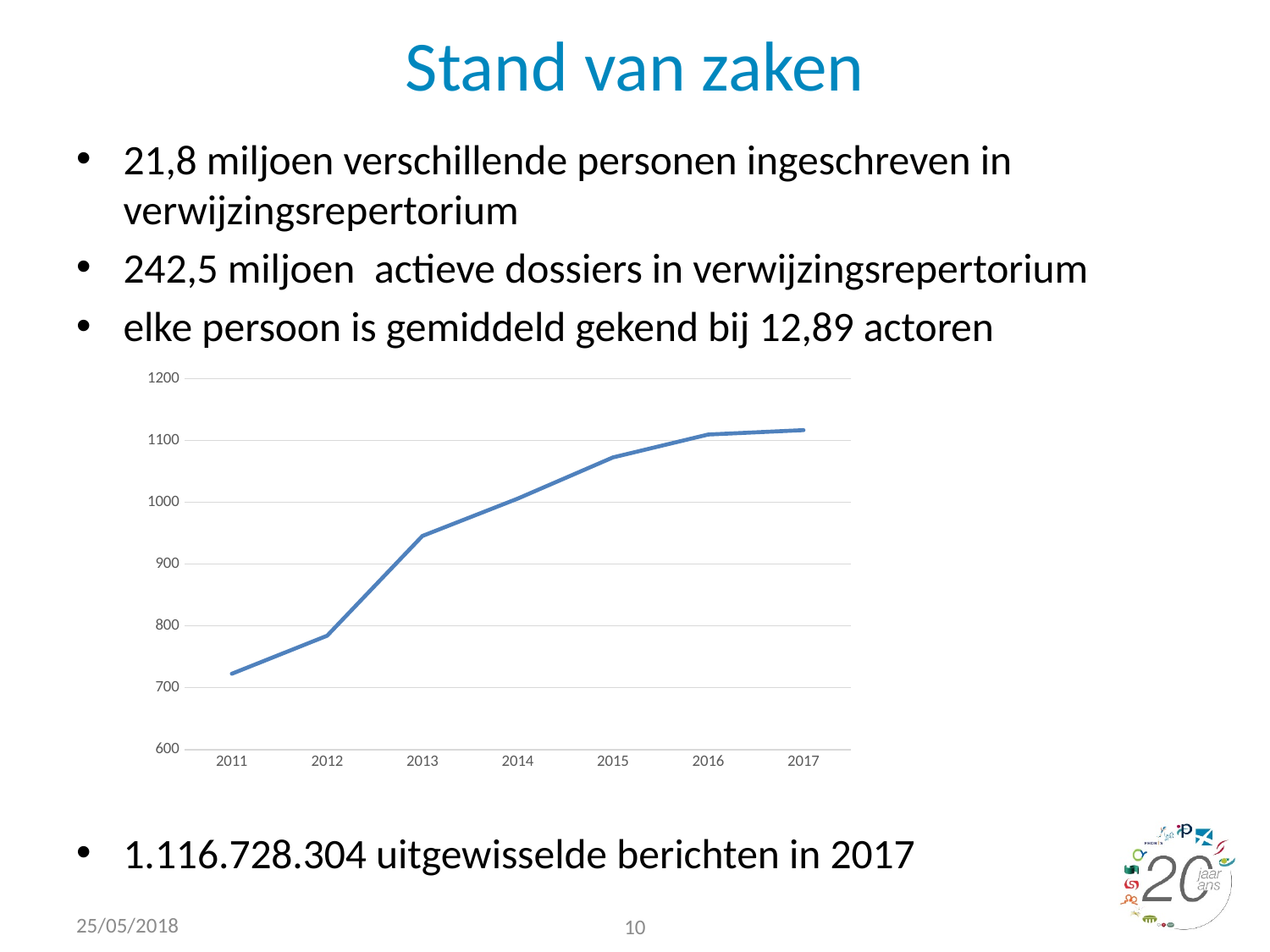
Which year has the larger value, 2012 or 2013? 2013 Is the value for 2017 greater or less than 1100? greater What kind of chart is shown on the slide? line chart Which year has the lowest value in the chart? 2011 Is the value for 2013 greater or less than 900? greater What is the first year shown on the x axis of the chart? 2011 What is the highest value shown on the y axis of the chart? 1200 Is the value for 2012 greater or less than 800? less Do the values in the chart rise or fall from 2011 to 2017? rise How many years are shown on the x axis of the chart? 7